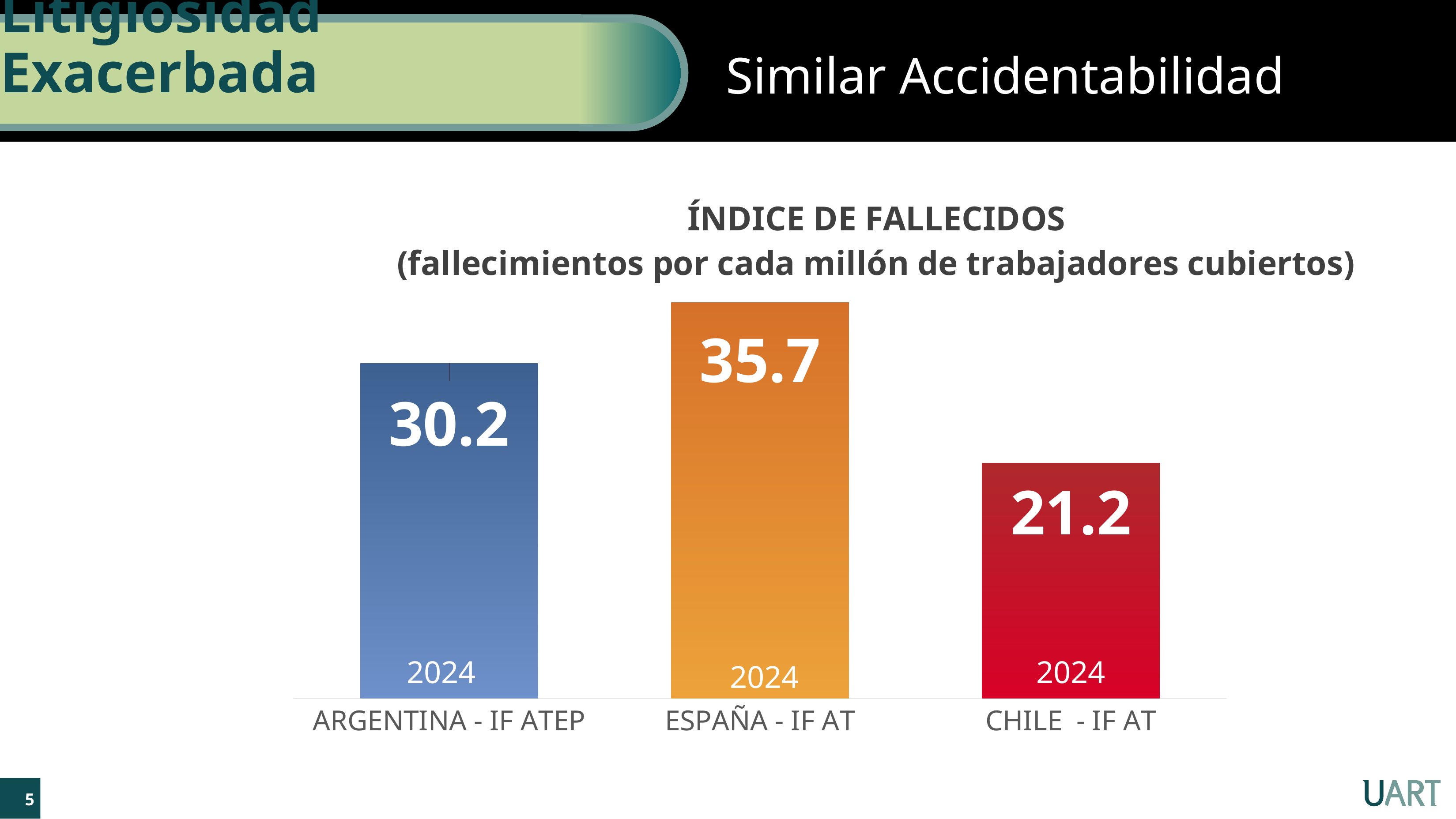
Which category has the lowest value? CHILE - IF AT What kind of chart is shown on the slide? bar chart What is the title of the chart? ÍNDICE DE FALLECIDOS (fallecimientos por cada millón de trabajadores cubiertos) What is the value for ARGENTINA - IF ATEP? 30.2 How many categories are shown in the chart? 3 What is the value for ESPAÑA - IF AT? 35.7 Which is larger, the value for ARGENTINA - IF ATEP or the value for CHILE - IF AT? ARGENTINA - IF ATEP What is the value for CHILE - IF AT? 21.2 Which year is labelled on each bar of the chart? 2024 Which category has the highest value? ESPAÑA - IF AT What is the difference between the values for ARGENTINA - IF ATEP and CHILE - IF AT? 9.0 What is the difference between the values for ESPAÑA - IF AT and ARGENTINA - IF ATEP? 5.5